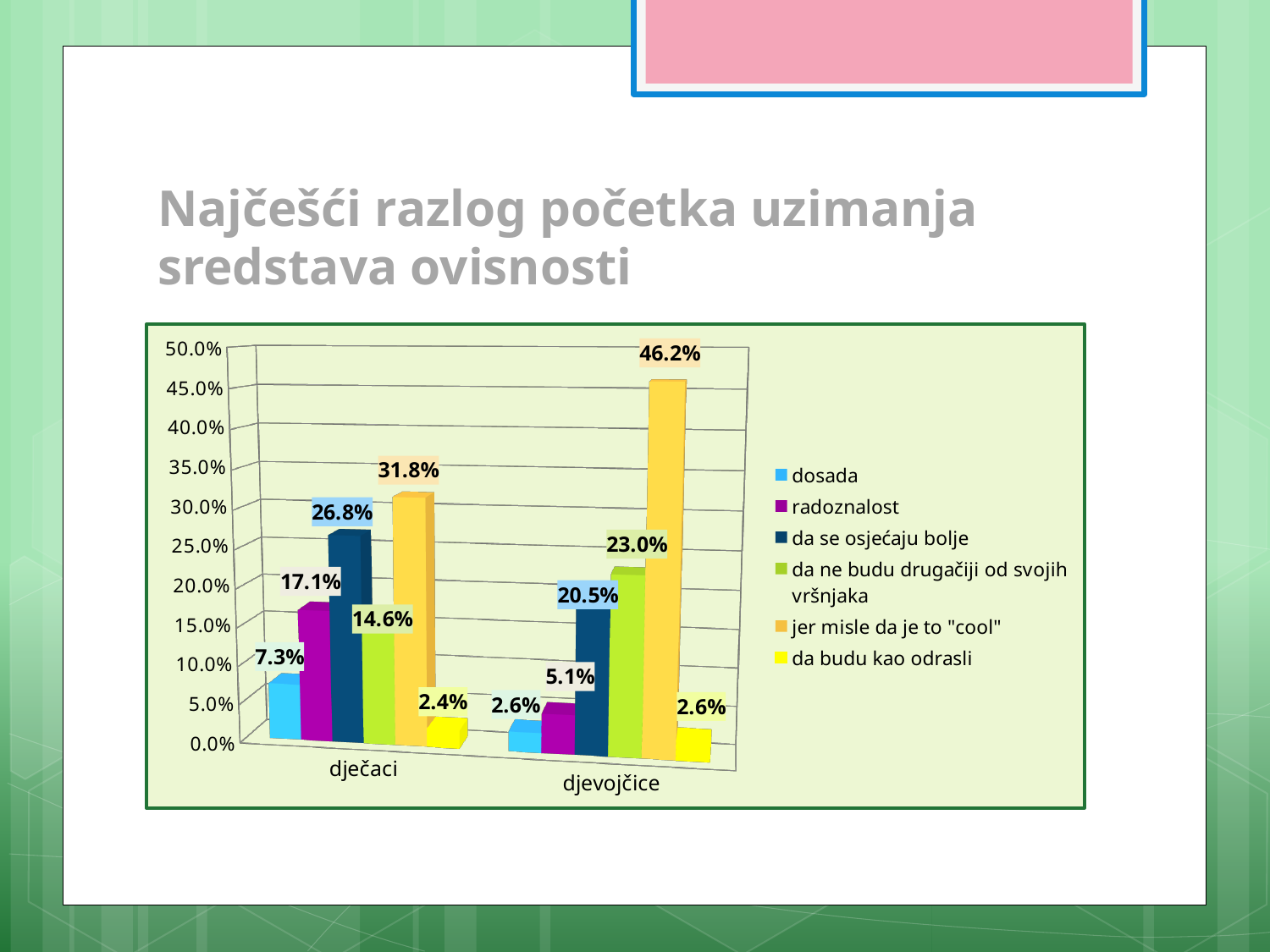
Which is larger: the "radoznalost" value for dječaci or for djevojčice? dječaci What is the value for "jer misle da je to "cool"" for djevojčice? 46.2% What is the difference between the "jer misle da je to "cool"" values for djevojčice and dječaci? 14.4% What is the value for "dosada" for dječaci? 7.3% Which series has the lowest value for dječaci? da budu kao odrasli What is the value for "radoznalost" for djevojčice? 5.1% Which series has the highest value for djevojčice? jer misle da je to "cool" What is the value for "da se osjećaju bolje" for dječaci? 26.8% What kind of chart is shown on the slide? bar chart What is the title of the slide above the chart? Najčešći razlog početka uzimanja sredstava ovisnosti How many series does the legend list? 6 How many categories are shown on the x axis? 2